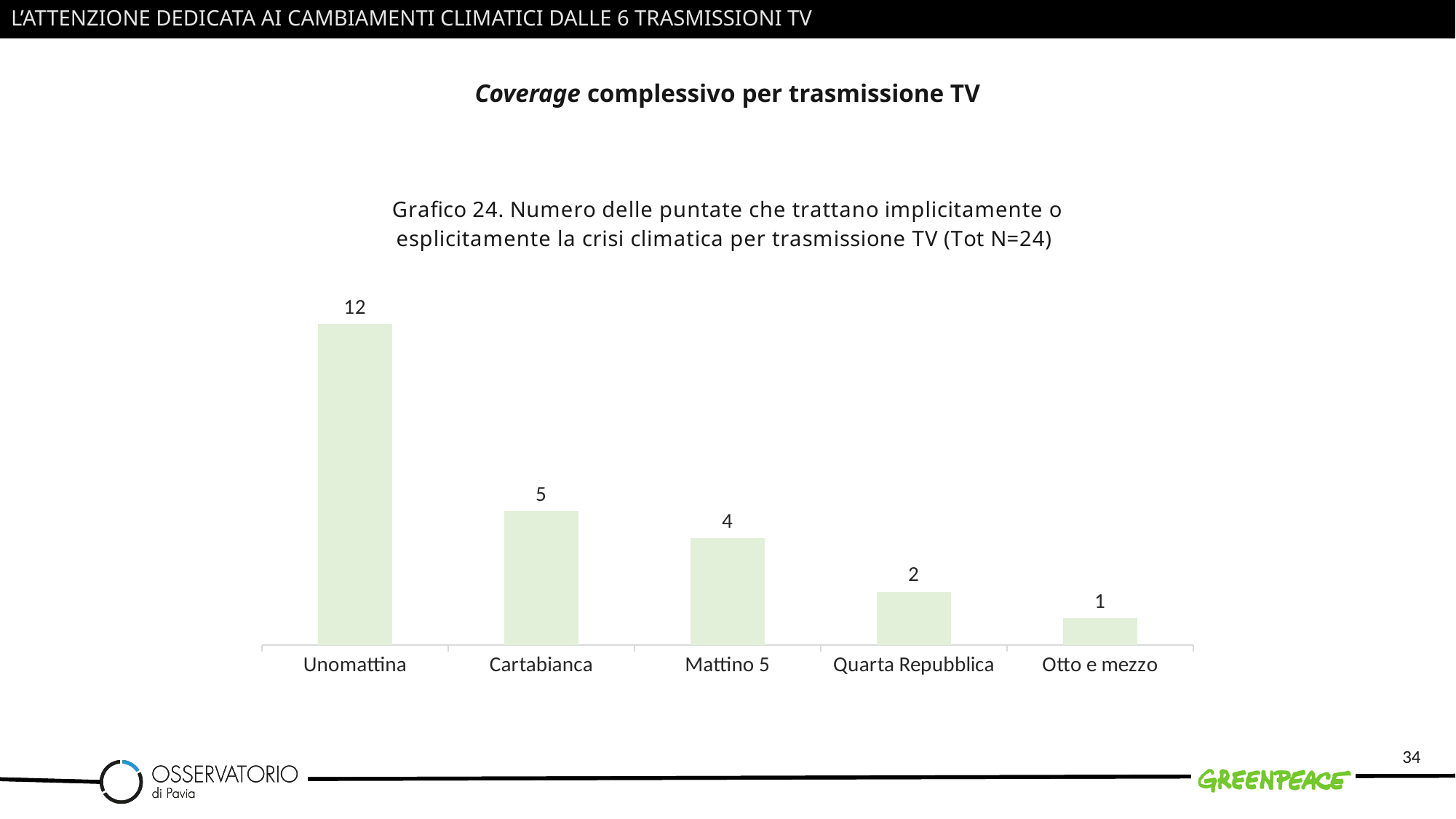
What is the value for Unomattina? 12 Which TV programme has the highest number of episodes? Unomattina Which has a larger value, Mattino 5 or Quarta Repubblica? Mattino 5 Which TV programme has the lowest number of episodes? Otto e mezzo What is the value for Mattino 5? 4 How many TV programmes are shown on the chart? 5 What is the difference between the values for Unomattina and Cartabianca? 7 What is the value for Cartabianca? 5 Do the values rise or fall from left to right along the x axis? Fall What kind of chart is shown on the slide? Bar chart What is the value for Quarta Repubblica? 2 What is the value for Otto e mezzo? 1